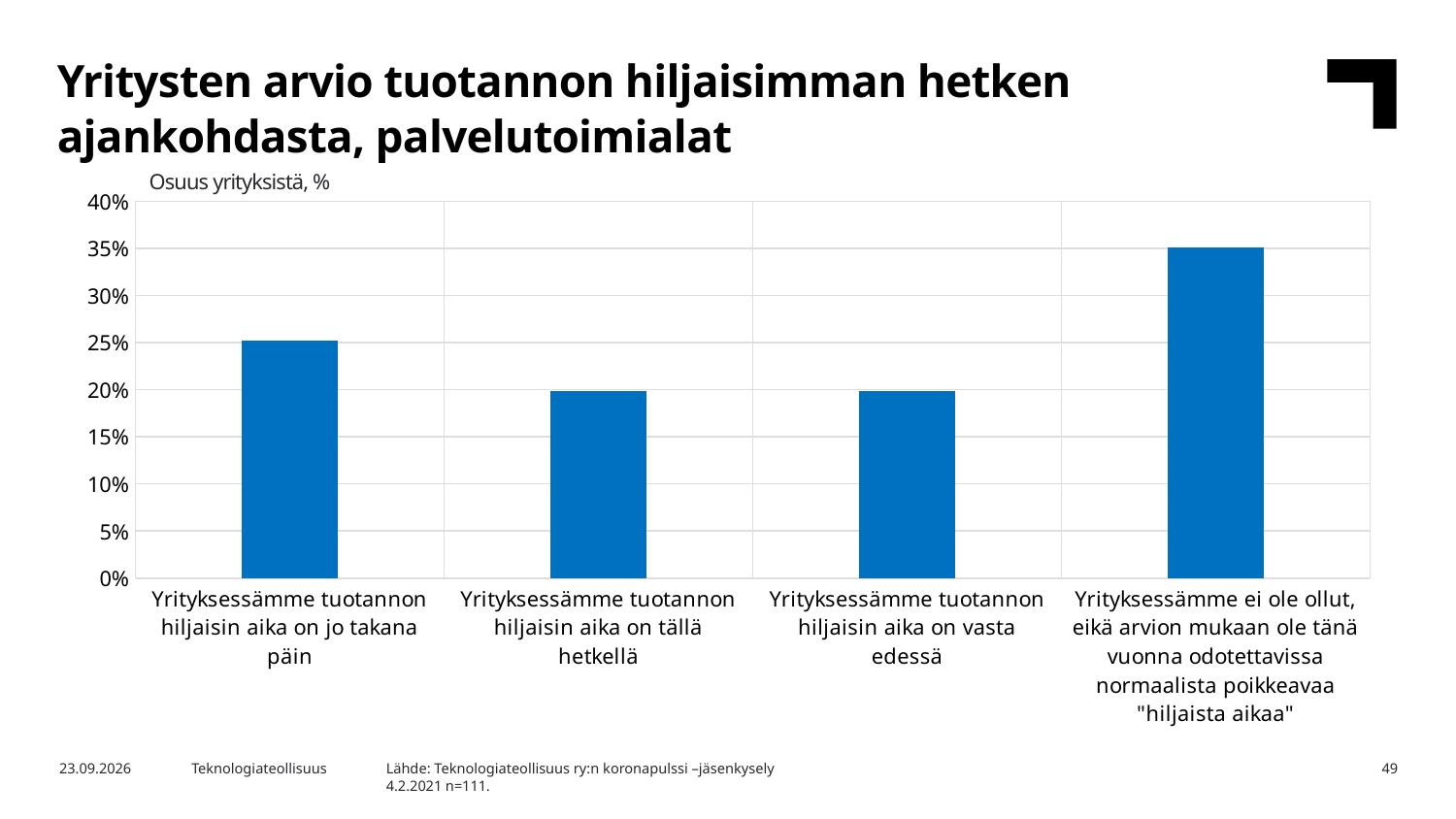
Is the value for "Yrityksessämme ei ole ollut, eikä arvion mukaan ole tänä vuonna odotettavissa normaalista poikkeavaa 'hiljaista aikaa'" greater or less than 30%? greater What kind of chart is shown on the slide? bar chart Is the value for "Yrityksessämme tuotannon hiljaisin aika on tällä hetkellä" greater or less than 25%? less Which category has the highest value in the chart? Yrityksessämme ei ole ollut, eikä arvion mukaan ole tänä vuonna odotettavissa normaalista poikkeavaa "hiljaista aikaa" How many categories are shown on the x axis of the chart? 4 Is the value for "Yrityksessämme tuotannon hiljaisin aika on vasta edessä" greater or less than 15%? greater Which is larger: the value for "Yrityksessämme tuotannon hiljaisin aika on jo takana päin" or the value for "Yrityksessämme tuotannon hiljaisin aika on tällä hetkellä"? Yrityksessämme tuotannon hiljaisin aika on jo takana päin What label is shown above the vertical axis of the chart? Osuus yrityksistä, % What is the title of the chart on the slide? Yritysten arvio tuotannon hiljaisimman hetken ajankohdasta, palvelutoimialat Which is larger: the value for "Yrityksessämme tuotannon hiljaisin aika on jo takana päin" or the value for "Yrityksessämme ei ole ollut, eikä arvion mukaan ole tänä vuonna odotettavissa normaalista poikkeavaa 'hiljaista aikaa'"? Yrityksessämme ei ole ollut, eikä arvion mukaan ole tänä vuonna odotettavissa normaalista poikkeavaa "hiljaista aikaa"